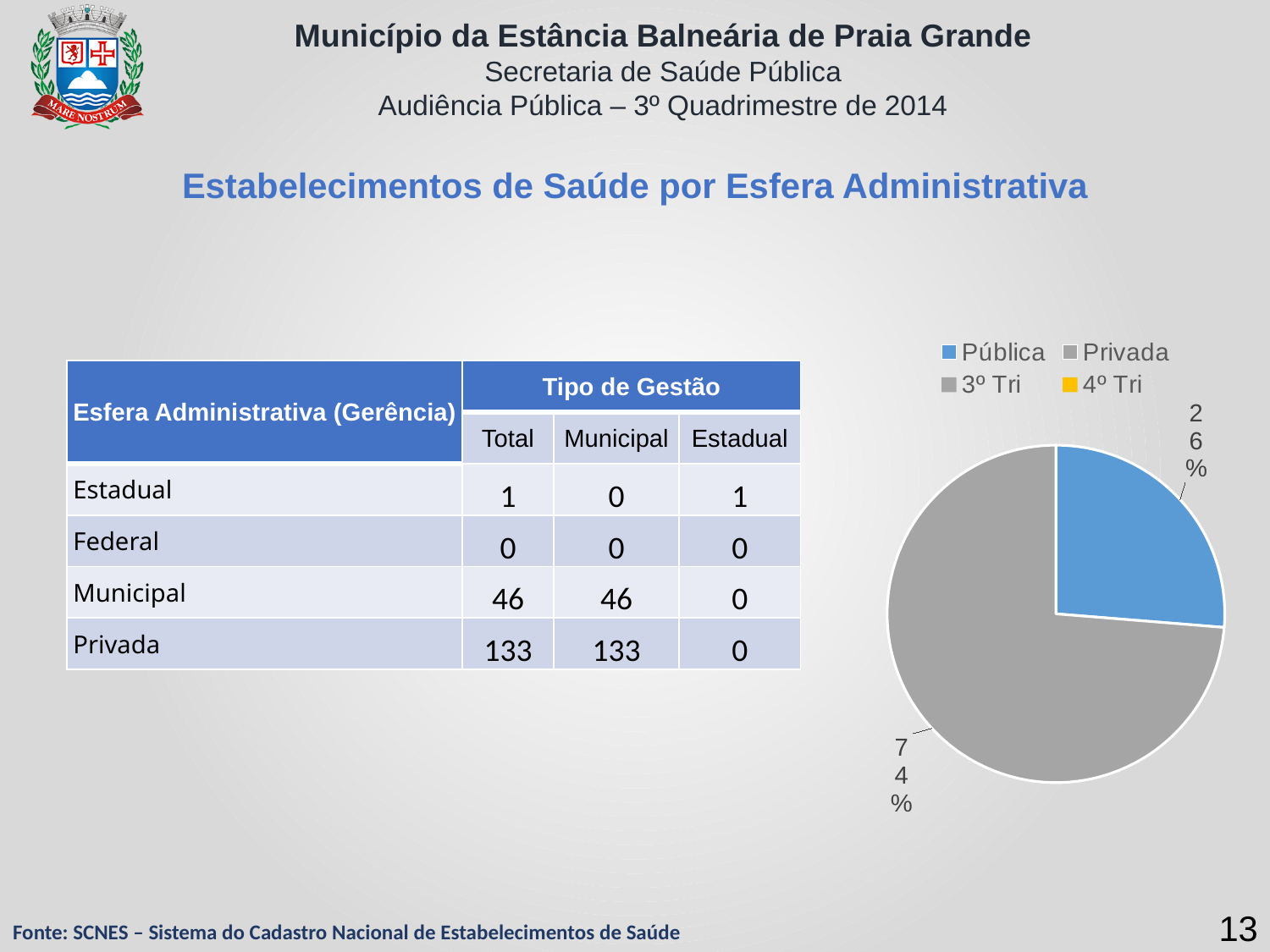
In the pie chart, what share is shown for Privada? 74% Which slice of the pie chart is the largest? Privada In the pie chart, which is larger, Pública or Privada? Privada What colour is the Pública slice in the pie chart? blue Is the Privada share in the pie chart greater or less than 50%? greater How many slices does the pie chart have? 2 How many entries does the legend of the pie chart list? 4 In the pie chart, what share is shown for Pública? 26% Which slice of the pie chart is the smallest? Pública What kind of chart is shown on the right of the slide? pie chart In the pie chart, what is the difference between the Privada share and the Pública share? 48% What colour is the Privada slice in the pie chart? gray